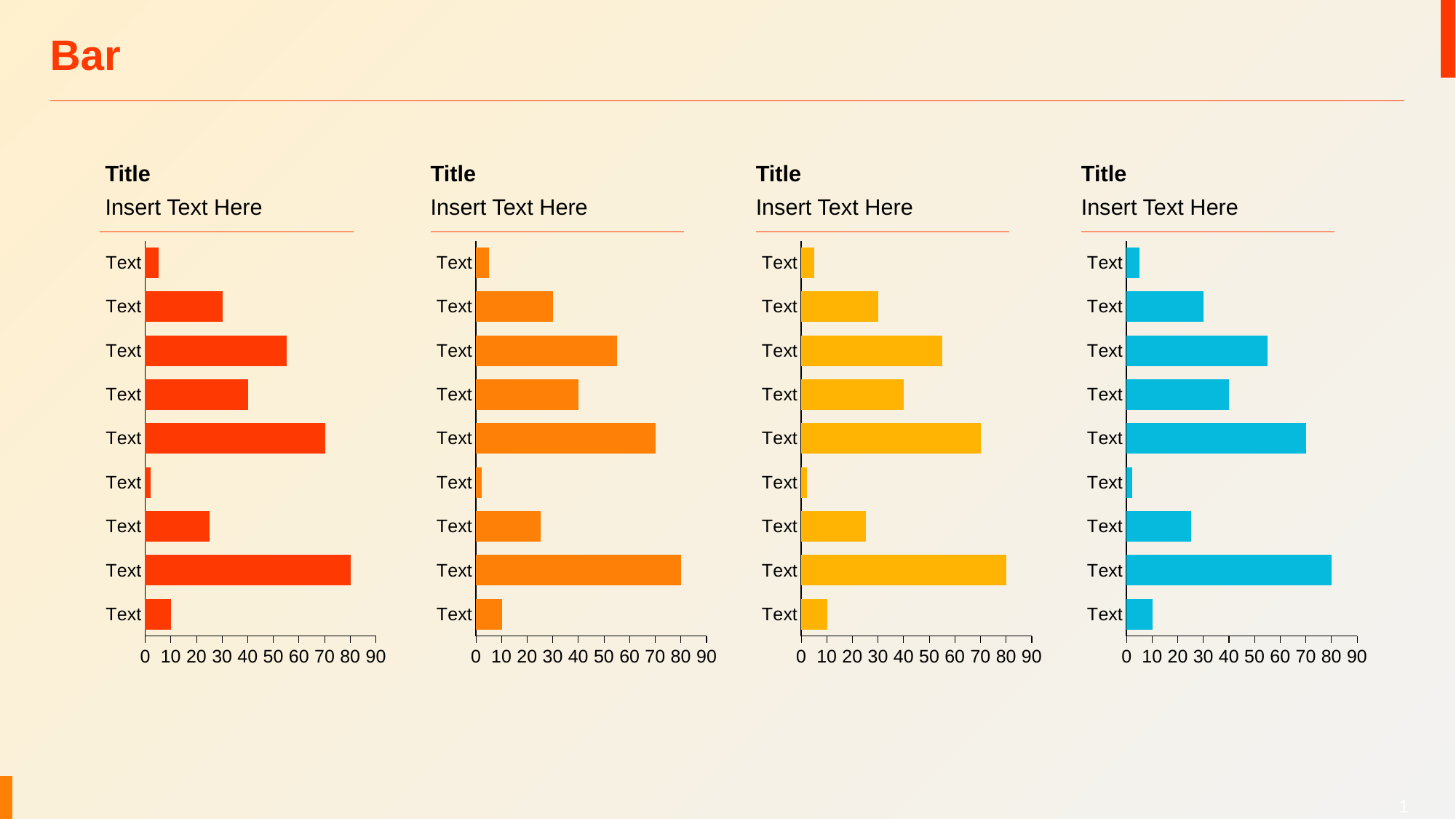
In the second chart from the left, is the value of the seventh bar from the top greater or less than 30? less In the leftmost chart, what is the value of the eighth bar from the top? 80 In the third chart from the left, is the value of the third bar from the top greater or less than 50? greater In the leftmost chart, which bar is the longest, counting from the top? the eighth bar What colour are the bars in the rightmost chart? blue How many bar charts are shown on the slide? 4 What kind of chart is the leftmost chart on the slide? bar chart In the leftmost chart, is the value of the fifth bar from the top greater or less than 60? greater How many bars does the leftmost chart have? 9 What is the highest value shown on the x axis of the rightmost chart? 90 In the rightmost chart, which bar is the shortest, counting from the top? the sixth bar In the rightmost chart, which is larger: the second bar from the top or the fourth bar from the top? the fourth bar